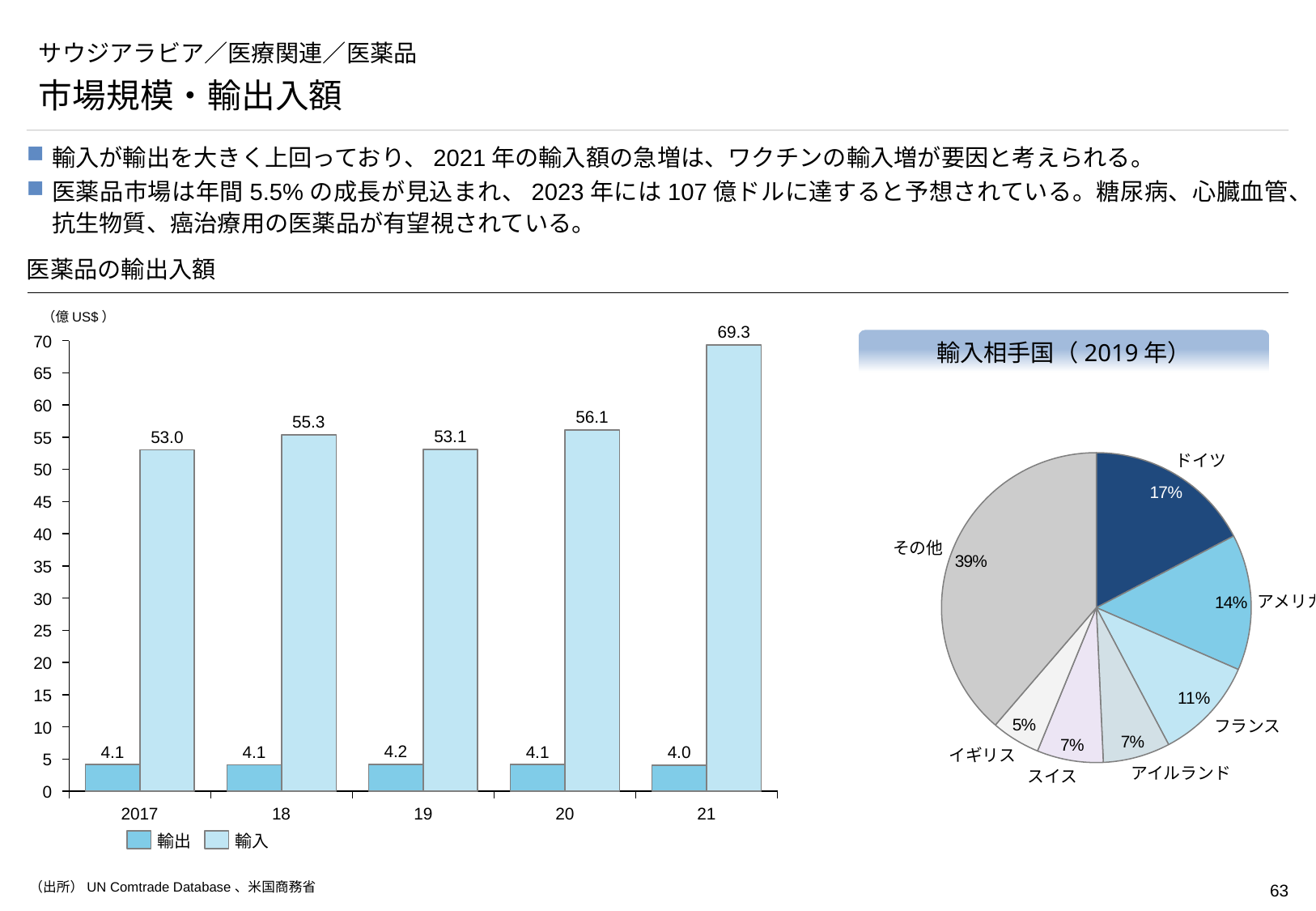
輸入相手国（2019年）の円グラフには、いくつの区分がありますか？ 7 医薬品の輸出入額のグラフで、2018年と2020年の輸入額はどちらが大きいですか？ 2020年 輸入相手国（2019年）の円グラフで、ドイツの割合は何％ですか？ 17% 医薬品の輸出入額のグラフで、凡例にはいくつの系列がありますか？ 2 医薬品の輸出入額のグラフで、2019年の輸出額はいくらですか？ 4.2 医薬品の輸出入額のグラフで、輸入額が最も低い年はどれですか？ 2017 医薬品の輸出入額のグラフで、2021年の輸入額はいくらですか？ 69.3 輸入相手国（2019年）の円グラフで、その他を除いて最も割合が大きい国はどこですか？ ドイツ 輸入相手国（2019年）の円グラフで、最も割合が小さい国はどこですか？ イギリス 医薬品の輸出入額のグラフで、輸入額が最も高い年はどれですか？ 21 医薬品の輸出入額のグラフは、どの種類のグラフですか？ 棒グラフ 医薬品の輸出入額のグラフで、2021年の輸入額と輸出額の差はいくらですか？ 65.3